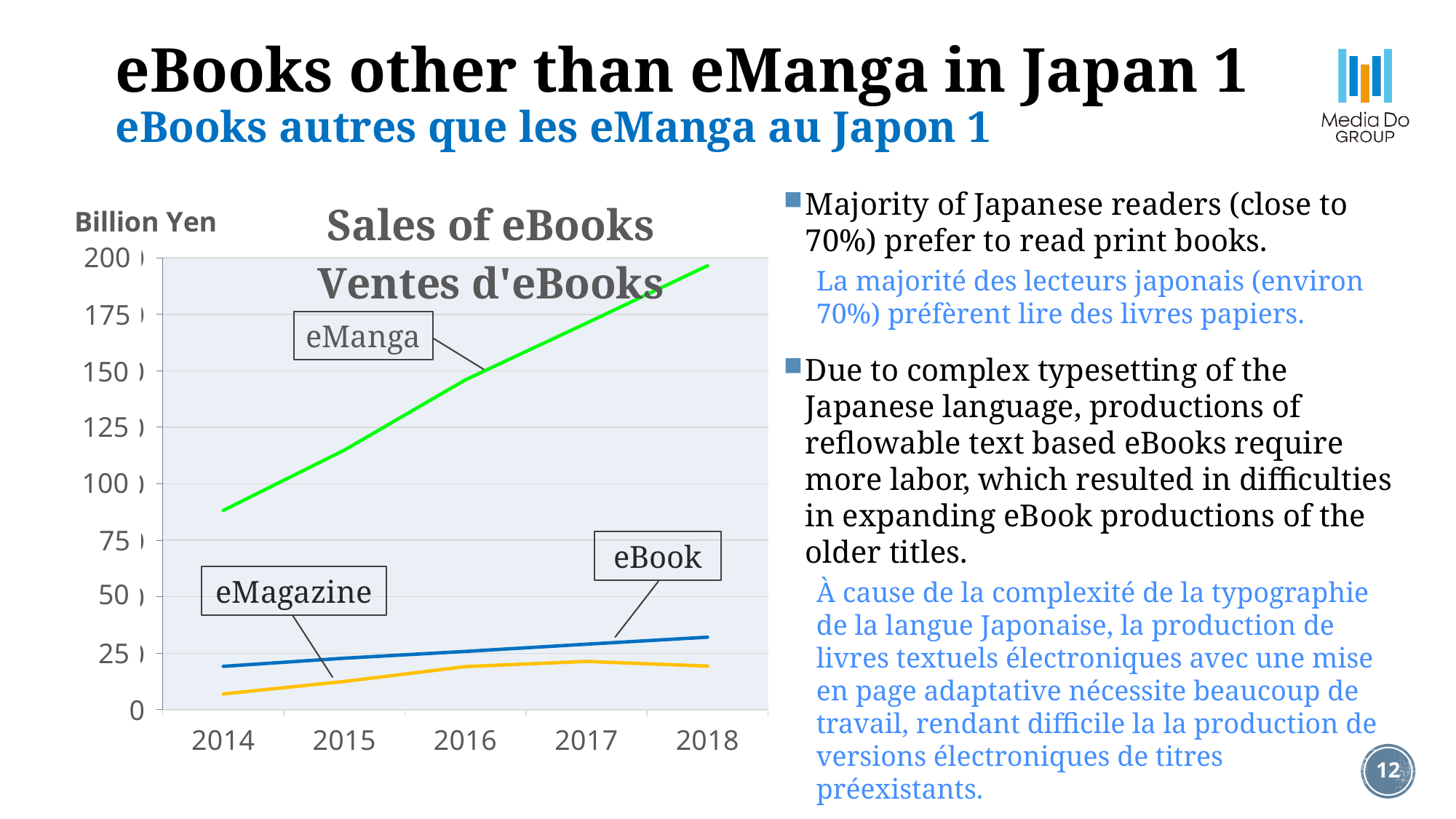
In 2018, which is larger: eBook or eMagazine? eBook Which series has the lowest value in 2014? eMagazine What unit is given for the y axis of the chart? Billion Yen Is the value for eBook in 2018 greater or less than 25? greater Which series has the highest value in 2018? eManga How many years are shown on the x axis of the chart? 5 Does the eManga series rise or fall from 2014 to 2018? rise Is the value for eMagazine in 2014 greater or less than 25? less Is the value for eManga in 2014 greater or less than 100? less What kind of chart is shown on the slide? line chart How many series are plotted in the Sales of eBooks chart? 3